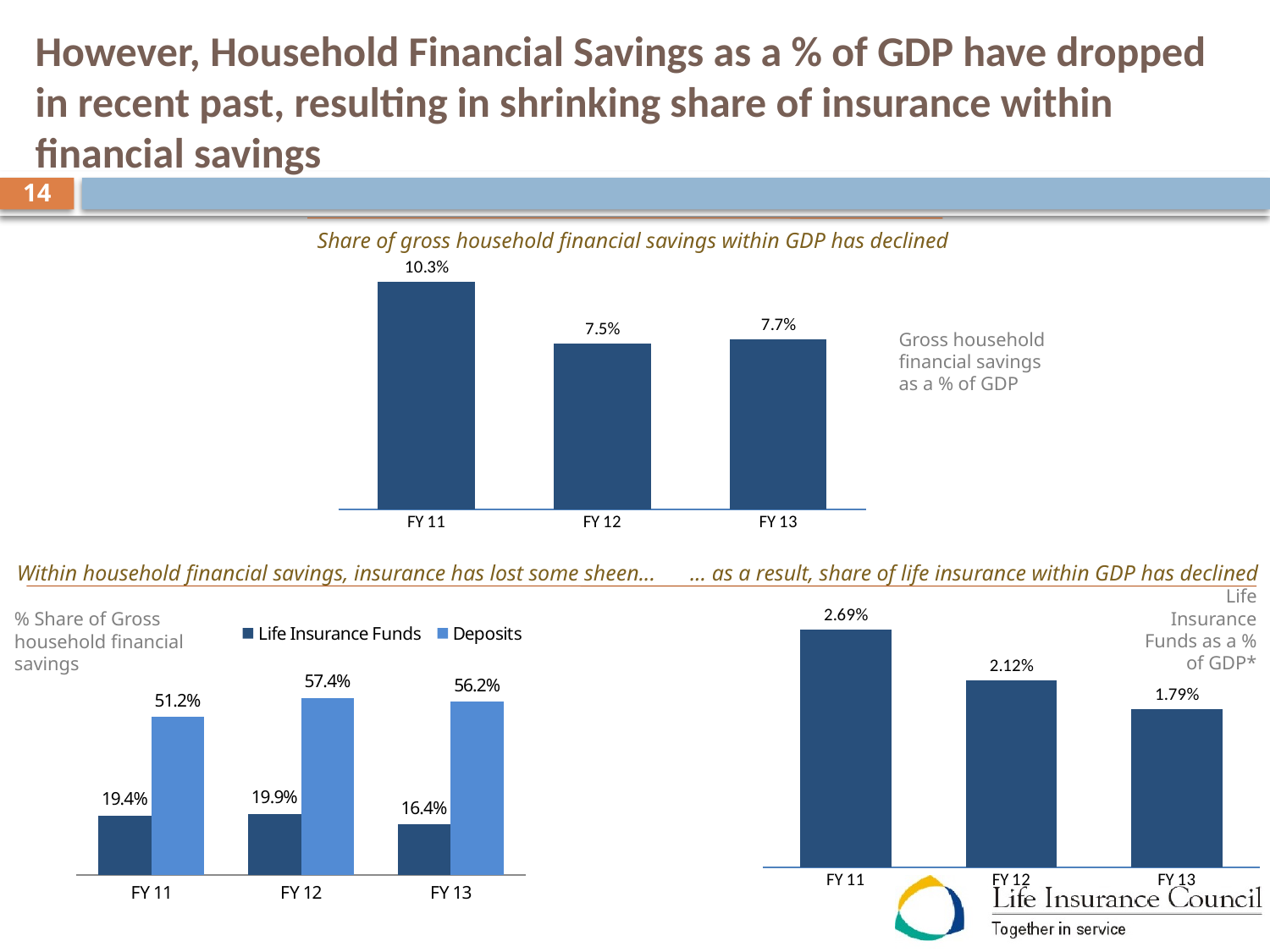
In the top chart, which fiscal year has the lowest gross household financial savings as a % of GDP? FY 12 In the bottom-left chart, what is the difference between Deposits and Life Insurance Funds in FY 11? 31.8% In the top chart, how many fiscal years are plotted? 3 In the bottom-left chart, which year has the highest Deposits share? FY 12 In the top chart, what is the difference between the FY 11 and FY 13 values? 2.6% In the bottom-left chart, what is the Deposits value for FY 12? 57.4% What kind of chart is the bottom-right chart? bar chart In the top chart, what is the value of gross household financial savings as a % of GDP for FY 11? 10.3% In the bottom-right chart, what is the value of Life Insurance Funds as a % of GDP for FY 13? 1.79% In the bottom-left chart, how many series does the legend list? 2 In the bottom-left chart, what is the Life Insurance Funds value for FY 13? 16.4% In the bottom-right chart, do the values rise or fall from FY 11 to FY 13? fall